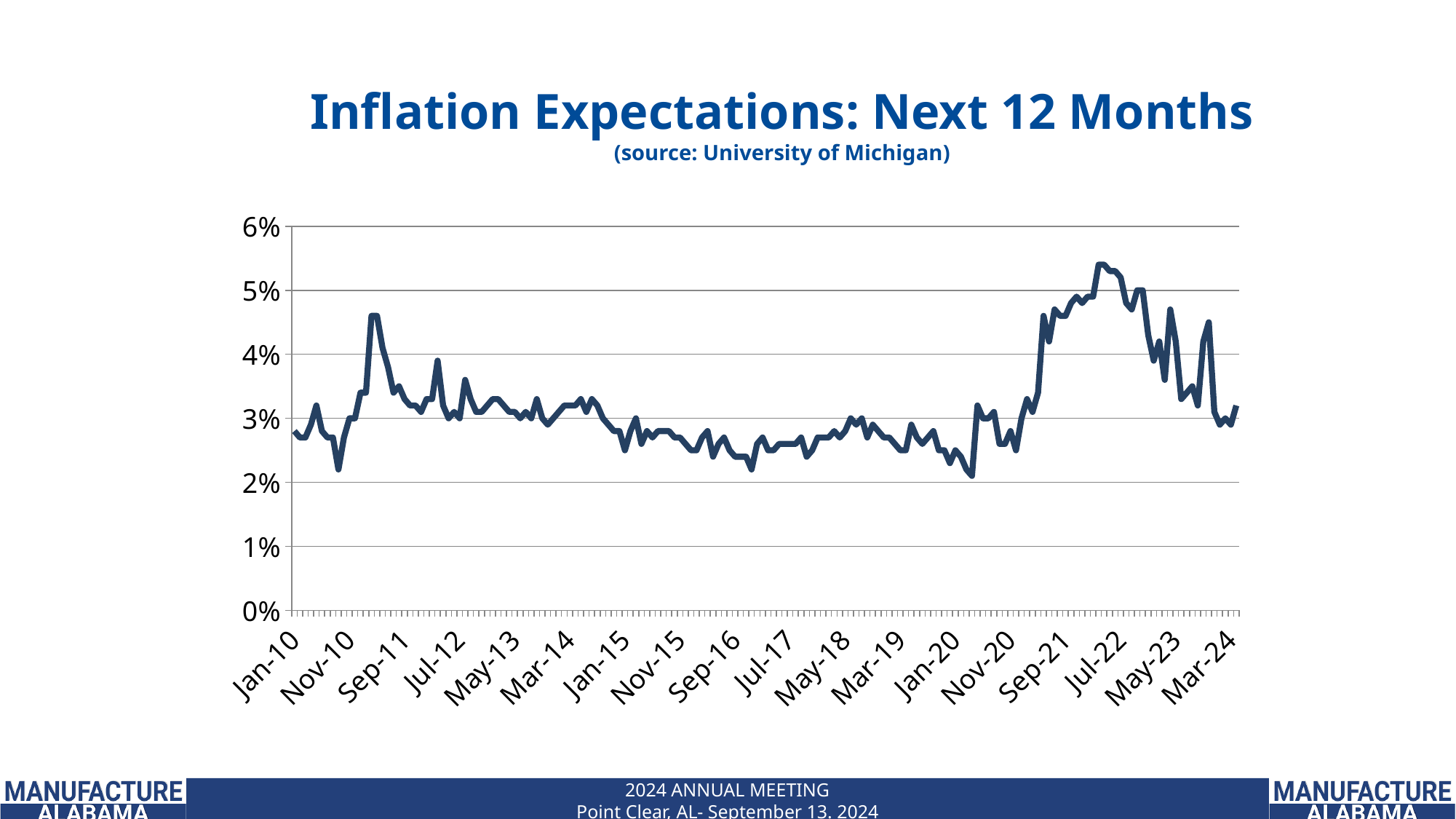
Which has the higher value, Sep-21 or Jan-15? Sep-21 Is the value at Jan-15 greater or less than 3%? less What is the title of the chart? Inflation Expectations: Next 12 Months What kind of chart is shown on the slide? line chart In which year does the line reach its highest point? 2022 Is the value at Sep-16 greater or less than 3%? less How many date labels are shown along the x axis? 18 Is the value at Mar-24 greater or less than 4%? less Does the line generally rise or fall between Jan-20 and Sep-21? rise What source is cited for the chart's data? University of Michigan